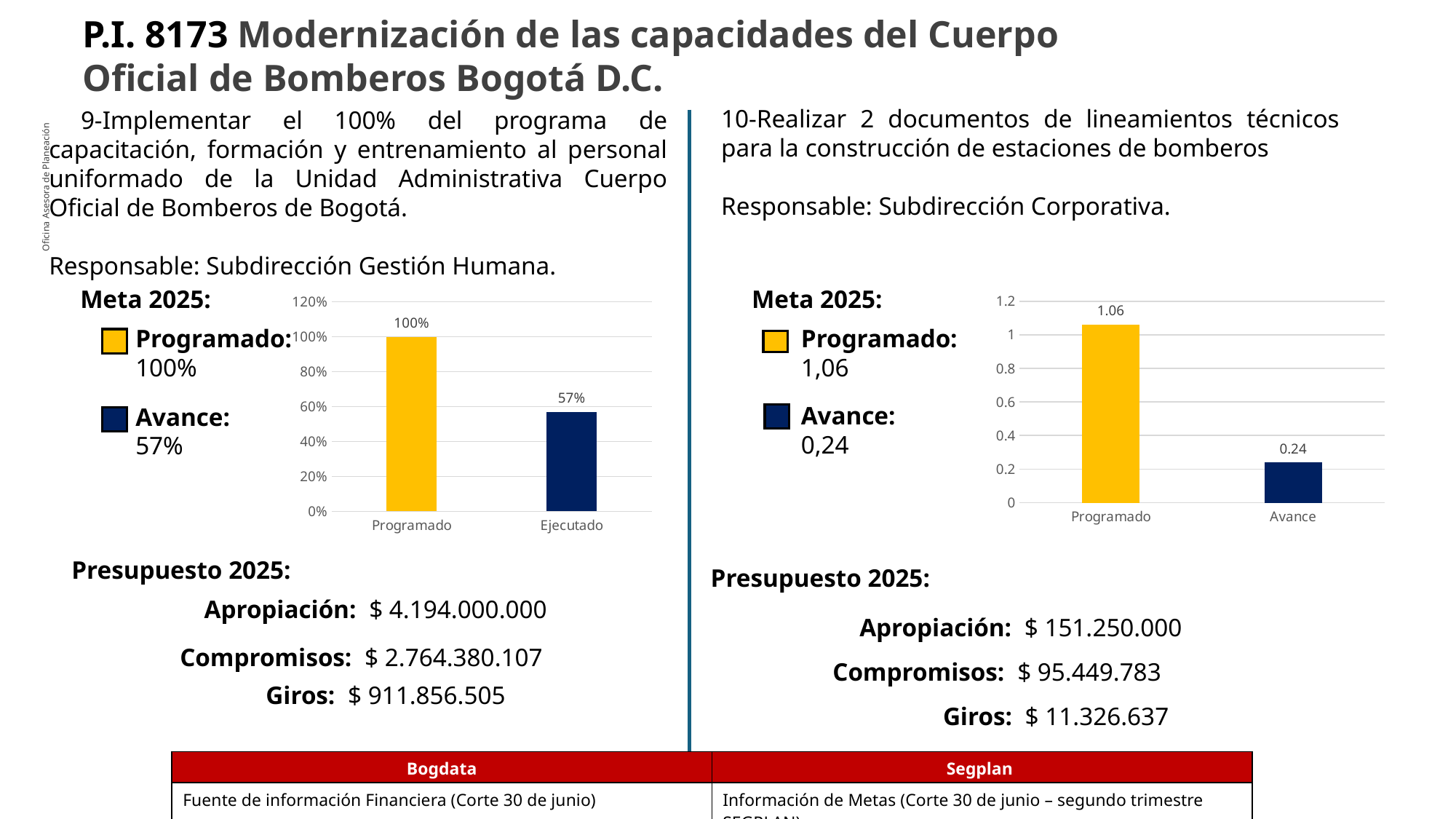
What kind of chart is the left chart? Bar chart In the right chart, is the value for Avance greater or less than 0.4? less In the right chart, what is the value for Avance? 0.24 In the right chart, what is the value for Programado? 1.06 In the right chart, which category has the higher value? Programado In the right chart, what colour is the Programado bar? Yellow In the left chart, what is the difference between the Programado and Ejecutado values? 43% In the left chart, what is the value for Programado? 100% In the right chart, what is the difference between the Programado and Avance values? 0.82 In the left chart, which category has the lower value? Ejecutado In the left chart, what is the value for Ejecutado? 57% In the left chart, how many bars are plotted? 2